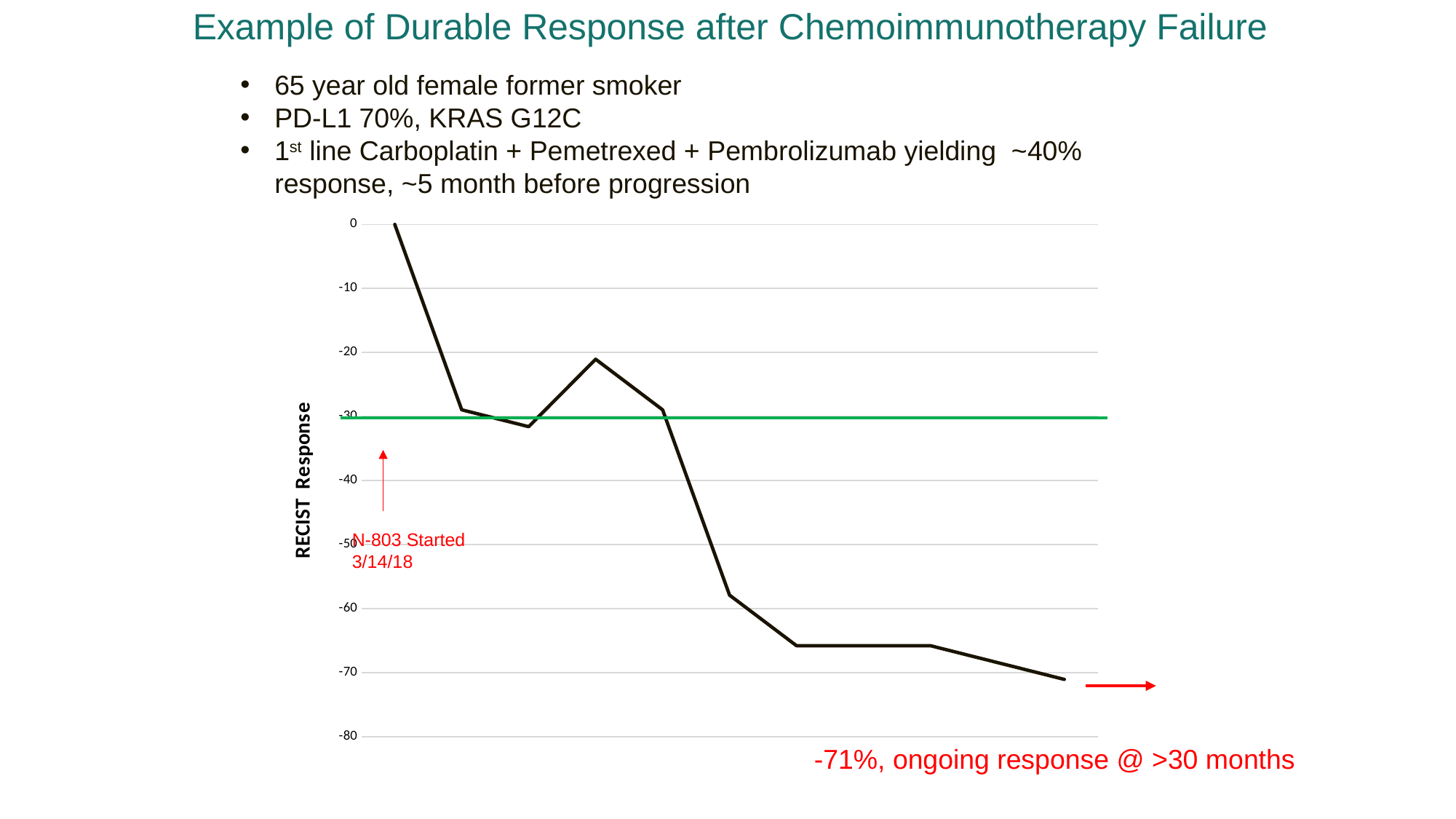
What is the value of the first point on the line? 0 What value does the annotation give for the final point on the line? -71% At what y-axis value is the green horizontal reference line drawn? -30 Which point on the line has the highest value, the first or the last? the first Is the value of the sixth point on the line greater or less than -50? less Overall, do the values on the line rise or fall from left to right? fall Is the value of the local peak in the middle of the line (the fourth point) greater or less than -30? greater What is the label of the vertical axis of the chart? RECIST Response What kind of chart is shown on the slide? line chart Is the value of the lowest point on the line greater or less than -60? less What is the lowest tick value shown on the vertical axis? -80